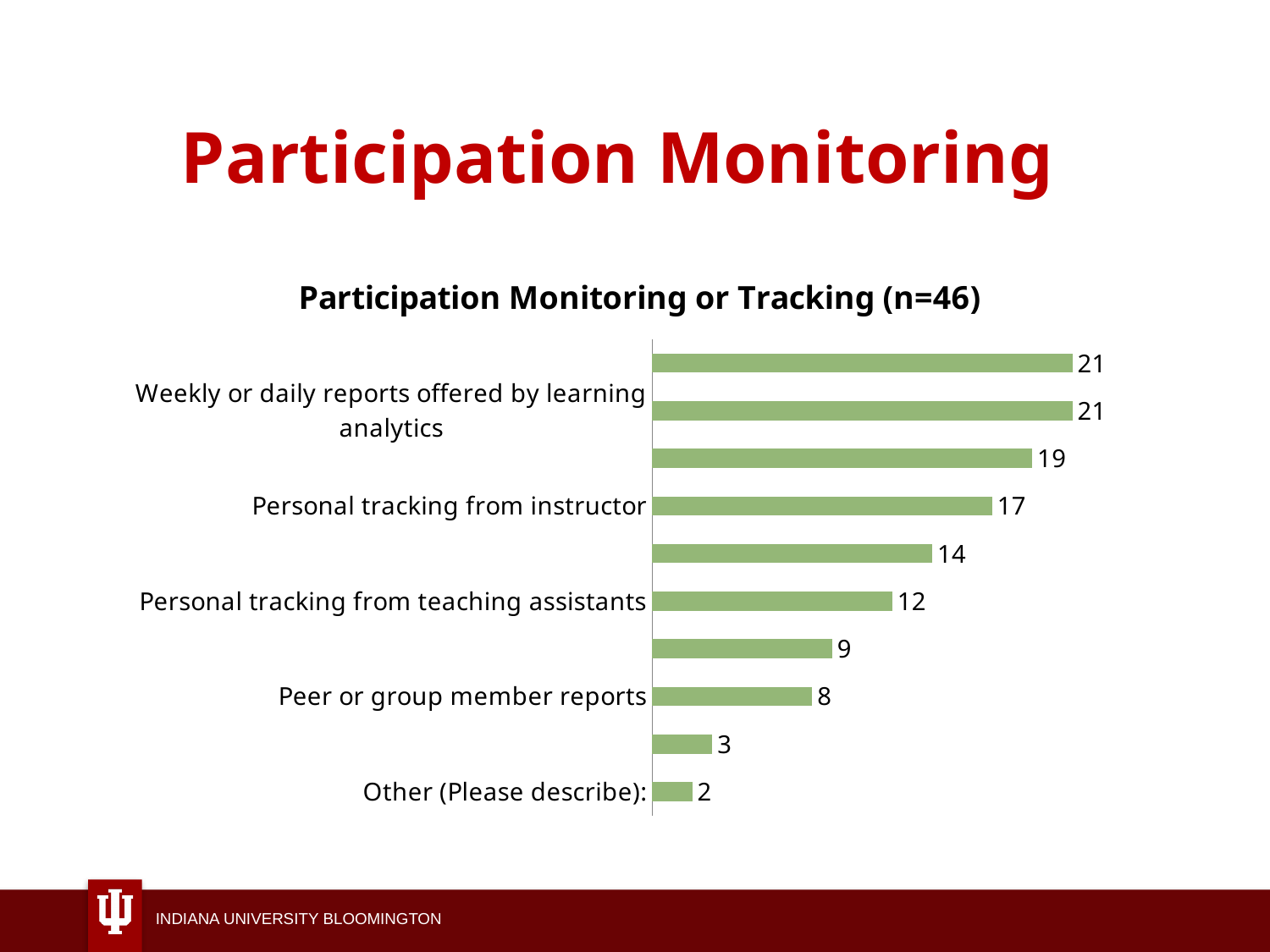
What is the value for "Peer or group member reports"? 8 Which is larger, the value for "Peer or group member reports" or the value for "Personal tracking from teaching assistants"? Personal tracking from teaching assistants How many bars are plotted in the chart? 10 What is the value for "Personal tracking from instructor"? 17 What is the value for "Personal tracking from teaching assistants"? 12 What is the value for "Other (Please describe):"? 2 Which labeled category has the lowest value? Other (Please describe): What is the difference between the values for "Personal tracking from instructor" and "Personal tracking from teaching assistants"? 5 What is the value for "Weekly or daily reports offered by learning analytics"? 21 What is the highest value shown on the chart? 21 What type of chart is shown on the slide? Bar chart What is the title of the chart? Participation Monitoring or Tracking (n=46)